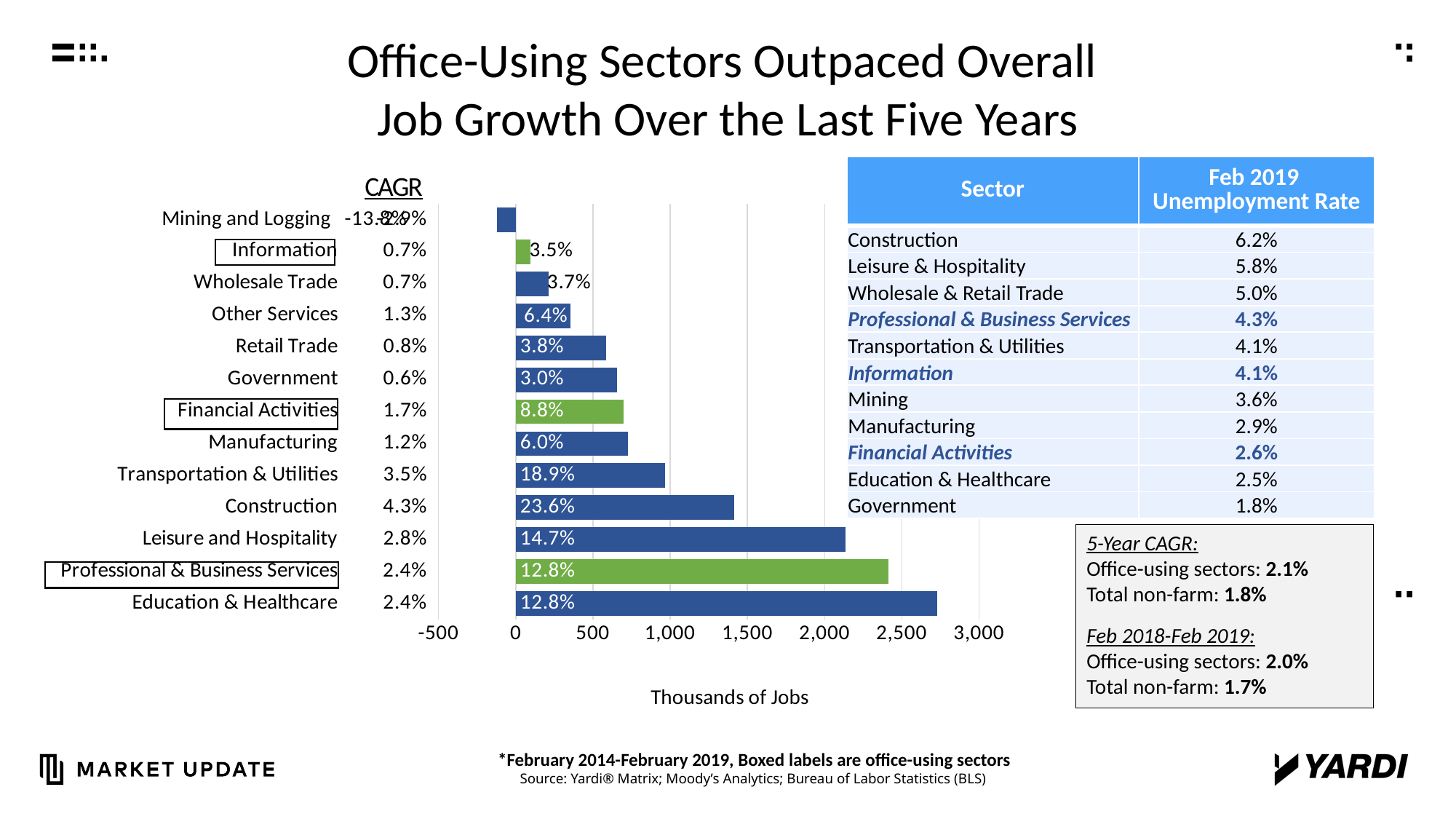
What percentage label is printed on the bar for Construction? 23.6% What is the difference between the percentage labels on the Construction bar and the Transportation & Utilities bar? 4.7% What percentage label is printed on the bar for Transportation & Utilities? 18.9% How many sectors are plotted in the bar chart? 13 What kind of chart is shown on the slide? bar chart Is the bar for Education & Healthcare greater or less than 2,500 thousand jobs? greater Which bar is longer, Leisure and Hospitality or Construction? Leisure and Hospitality Which sector has the longest bar in the chart? Education & Healthcare Which sector has the lowest (negative) bar in the chart? Mining and Logging What is the title of the horizontal axis of the bar chart? Thousands of Jobs What percentage label is printed on the bar for Financial Activities? 8.8% Is the bar for Construction greater or less than 1,500 thousand jobs? less